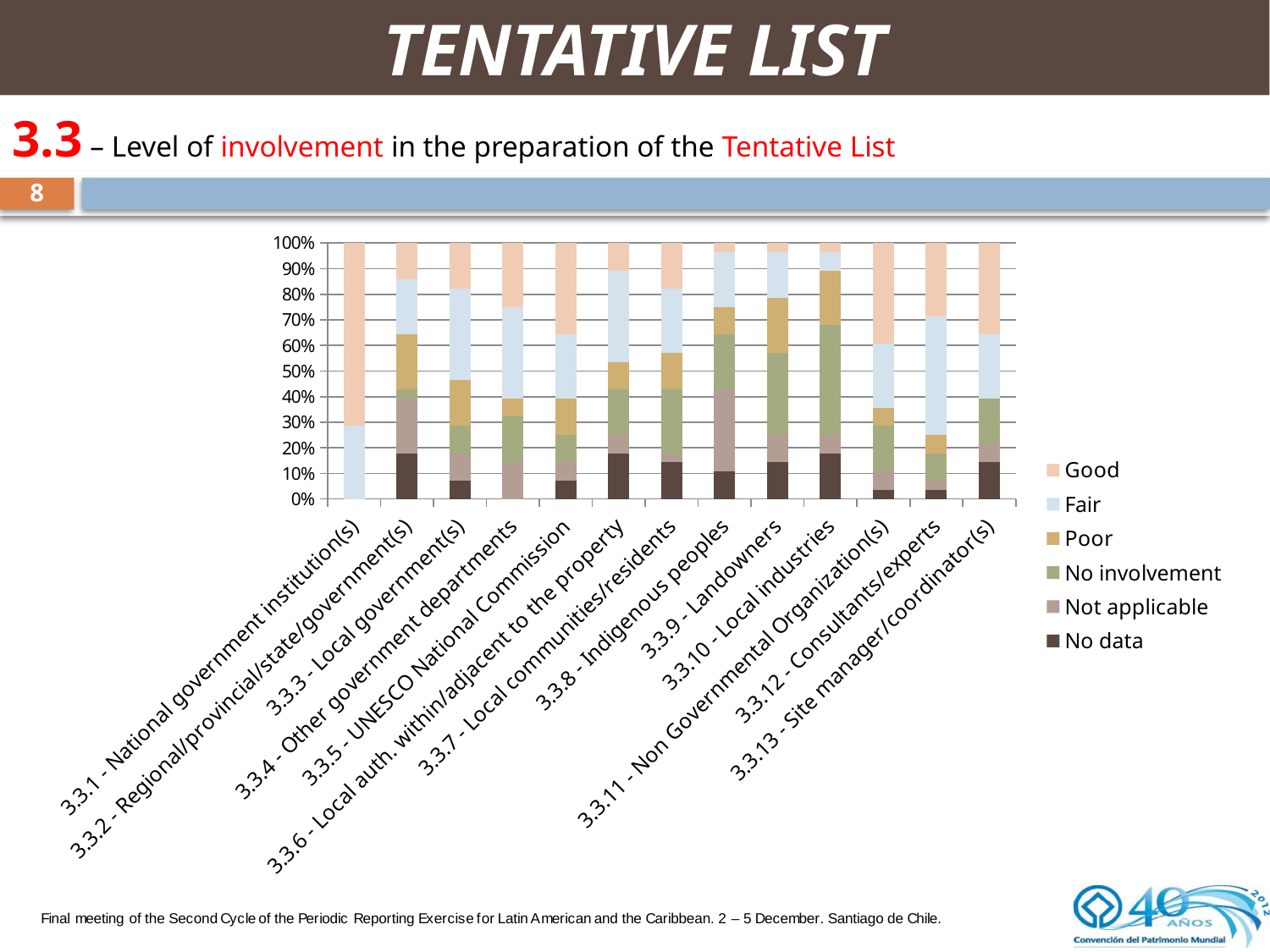
Which series is listed last in the chart legend? No data Which category has the largest 'Good' share? 3.3.1 - National government institution(s) How many categories are plotted along the x axis of the chart? 13 Which series is listed first in the chart legend? Good Which has the larger 'Good' share: 3.3.1 - National government institution(s) or 3.3.13 - Site manager/coordinator(s)? 3.3.1 - National government institution(s) What does each stacked bar in the chart total? 100% Is the 'Good' share for 3.3.8 - Indigenous peoples greater or less than 10%? less How many series does the chart legend list? 6 What kind of chart is shown on the slide? Stacked bar chart Is the 'Good' share for 3.3.1 - National government institution(s) greater or less than 50%? greater Which has the larger 'Fair' share: 3.3.12 - Consultants/experts or 3.3.1 - National government institution(s)? 3.3.12 - Consultants/experts Which category has the largest 'No involvement' share? 3.3.10 - Local industries